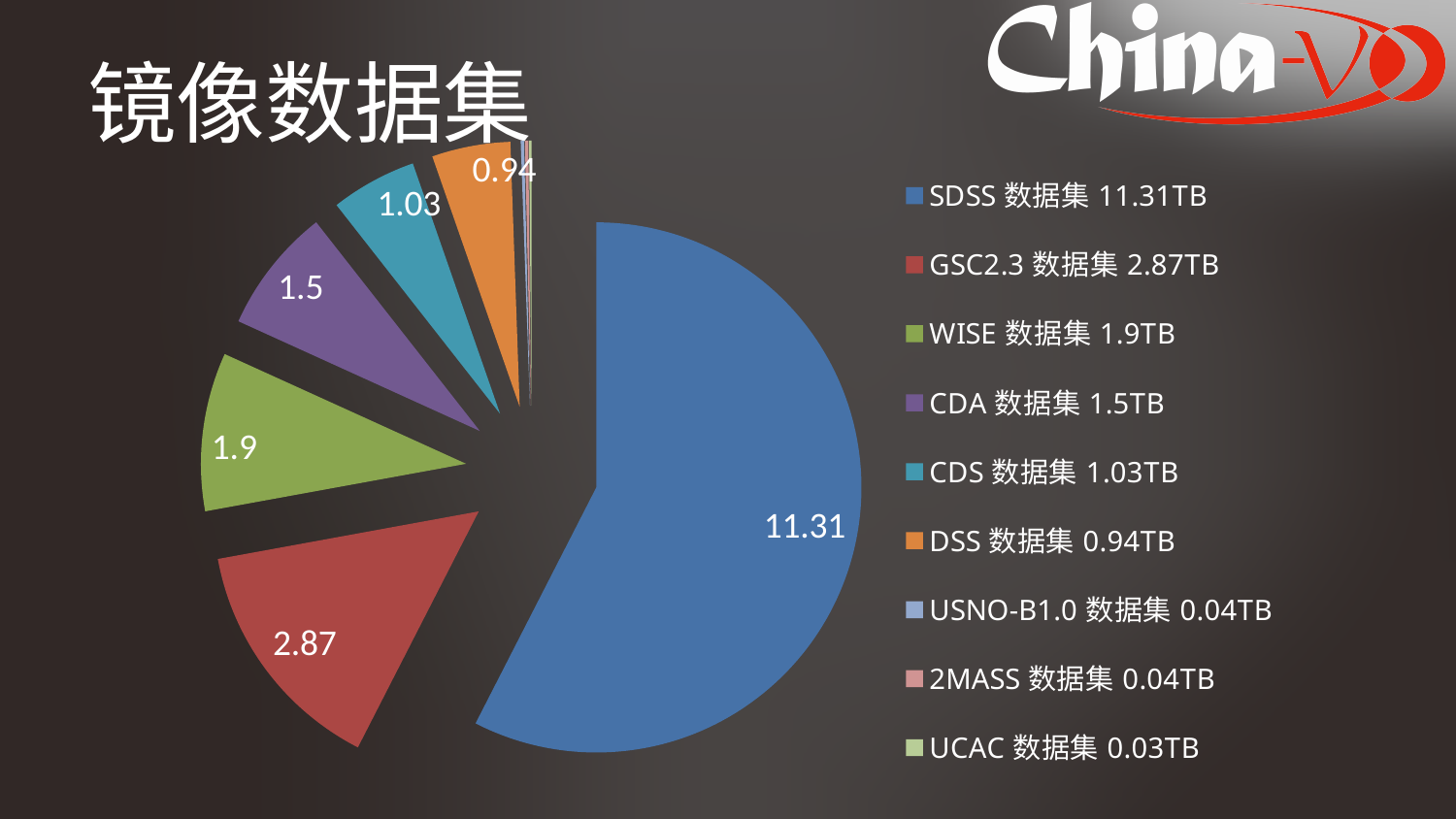
Which is larger, the GSC2.3 数据集 or the WISE 数据集? GSC2.3 数据集 What colour is the slice representing the SDSS 数据集? blue What is the data label shown on the largest slice of the pie chart? 11.31 Which dataset has the smallest value listed in the legend? UCAC 数据集 What is the difference in TB between the SDSS 数据集 and the GSC2.3 数据集? 8.44TB What is the title of the chart on the slide? 镜像数据集 According to the legend, what is the size of the GSC2.3 数据集? 2.87TB How many datasets are listed in the legend of the pie chart? 9 According to the legend, what is the size of the CDS 数据集? 1.03TB Which dataset has the largest slice in the pie chart? SDSS 数据集 What type of chart is shown on the slide? pie chart According to the legend, what is the size of the DSS 数据集? 0.94TB